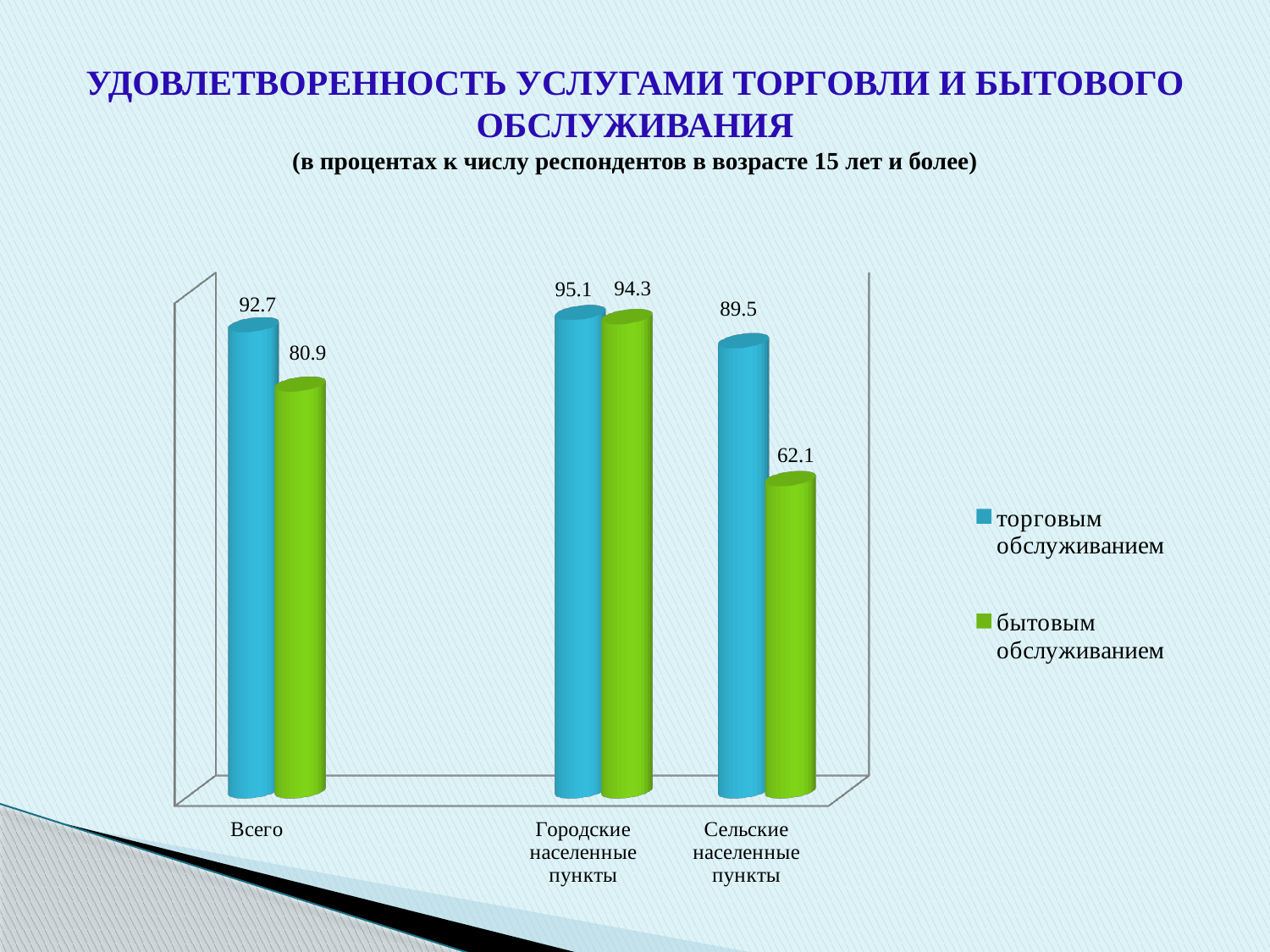
Which is larger in the Городские населенные пункты category: торговым обслуживанием or бытовым обслуживанием? торговым обслуживанием How many series does the legend list? 2 What is the difference between торговым обслуживанием and бытовым обслуживанием in the Сельские населенные пункты category? 27.4 How many categories are shown on the x axis? 3 Which colour represents бытовым обслуживанием in the chart? green Which category has the highest value for торговым обслуживанием? Городские населенные пункты What is the value for торговым обслуживанием in the Всего category? 92.7 Which category has the lowest value for бытовым обслуживанием? Сельские населенные пункты What is the difference between торговым обслуживанием and бытовым обслуживанием in the Всего category? 11.8 What is the value for бытовым обслуживанием in the Городские населенные пункты category? 94.3 What is the value for бытовым обслуживанием in the Сельские населенные пункты category? 62.1 What kind of chart is shown on the slide? bar chart